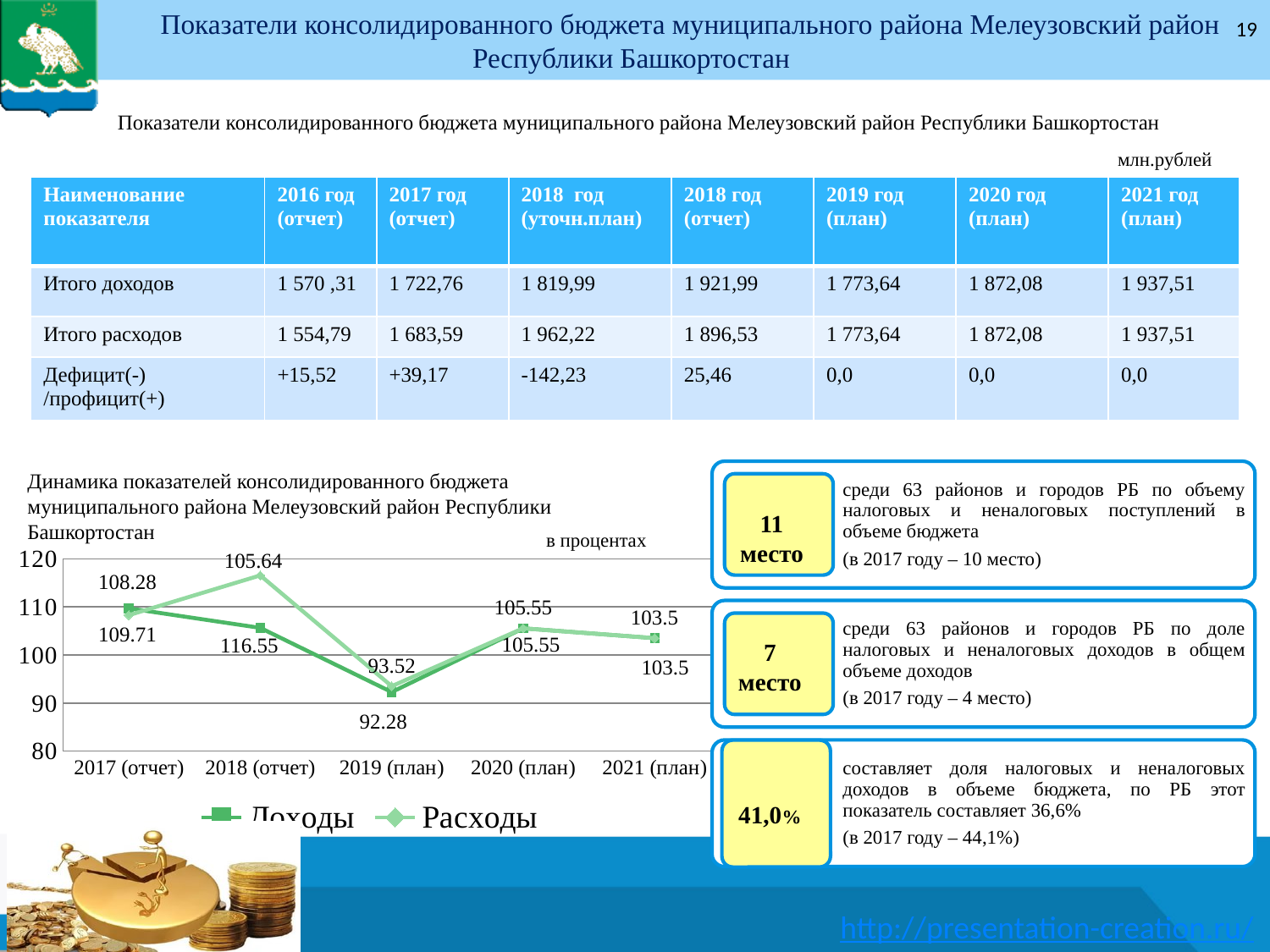
How many categories are shown on the x axis of the chart? 5 In which category does the Расходы series reach its highest value? 2018 (отчет) At 2018 (отчет), which series is higher, Доходы or Расходы? Расходы What is the value for Доходы in 2020 (план)? 105.55 What are the two series named in the chart legend? Доходы and Расходы Is the value for Расходы in 2018 (отчет) greater or less than 110? greater What is the value for Расходы in 2021 (план)? 103.5 How many series does the chart legend list? 2 Is the value for Расходы in 2019 (план) greater or less than 100? less What unit label is shown above the chart's plot area? в процентах In which category does the Доходы series reach its lowest value? 2019 (план) What kind of chart is shown on the slide? line chart